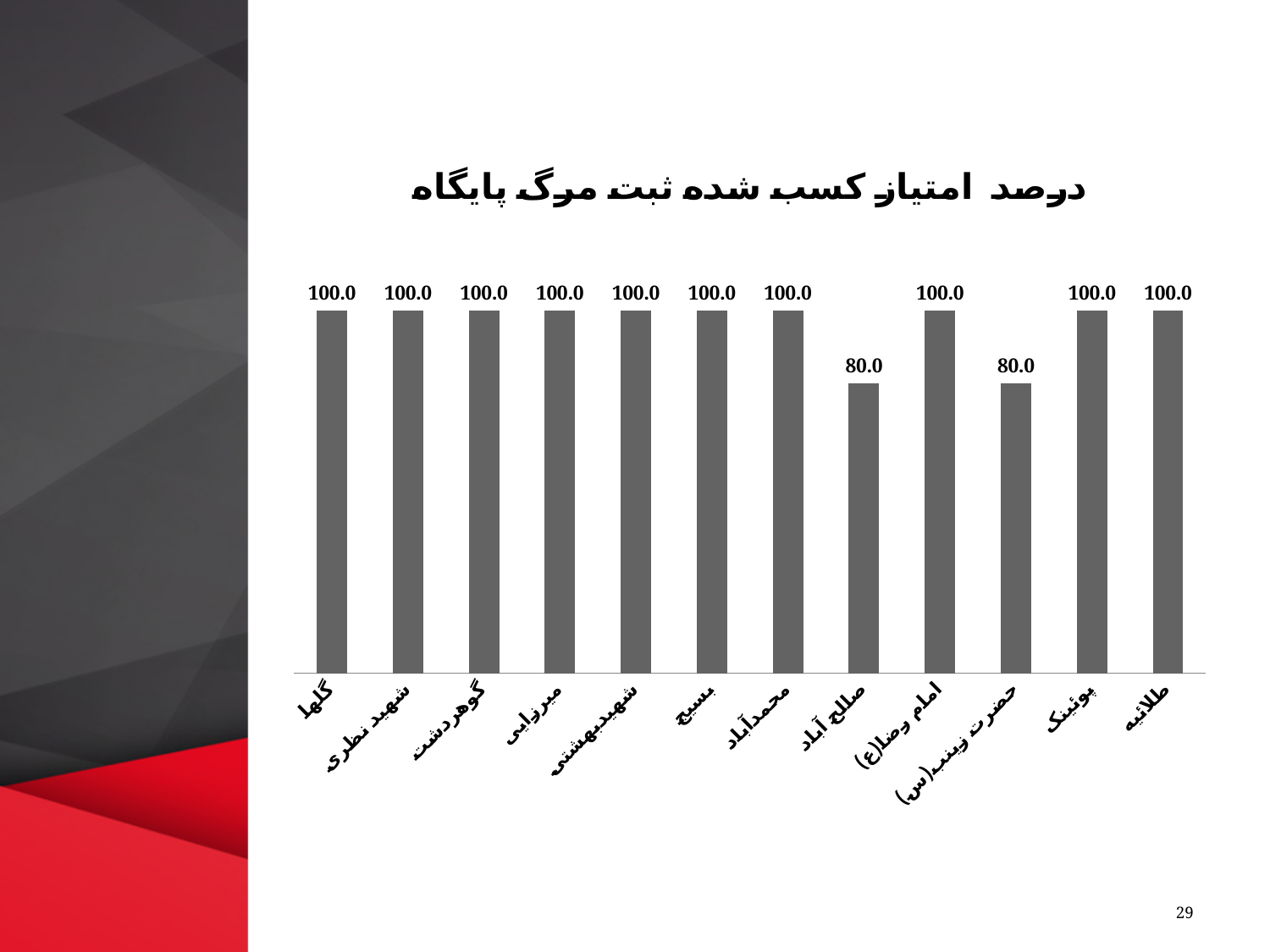
What is the value for حضرت زینب(س)? 80.0 What kind of chart is shown on the slide? bar chart Which is larger, the value for محمدآباد or the value for صالح آباد? محمدآباد What is the value for صالح آباد? 80.0 What is the value for پوئینک? 100.0 Which category has the lowest value, صالح آباد or بسیج? صالح آباد What is the value for گلها? 100.0 What is the title of the chart? درصد امتیاز کسب شده ثبت مرگ پایگاه How many categories have a value of 80.0? 2 What is the difference between the values for امام رضا(ع) and حضرت زینب(س)? 20.0 What is the value for طلائیه? 100.0 How many categories are shown on the x axis? 12